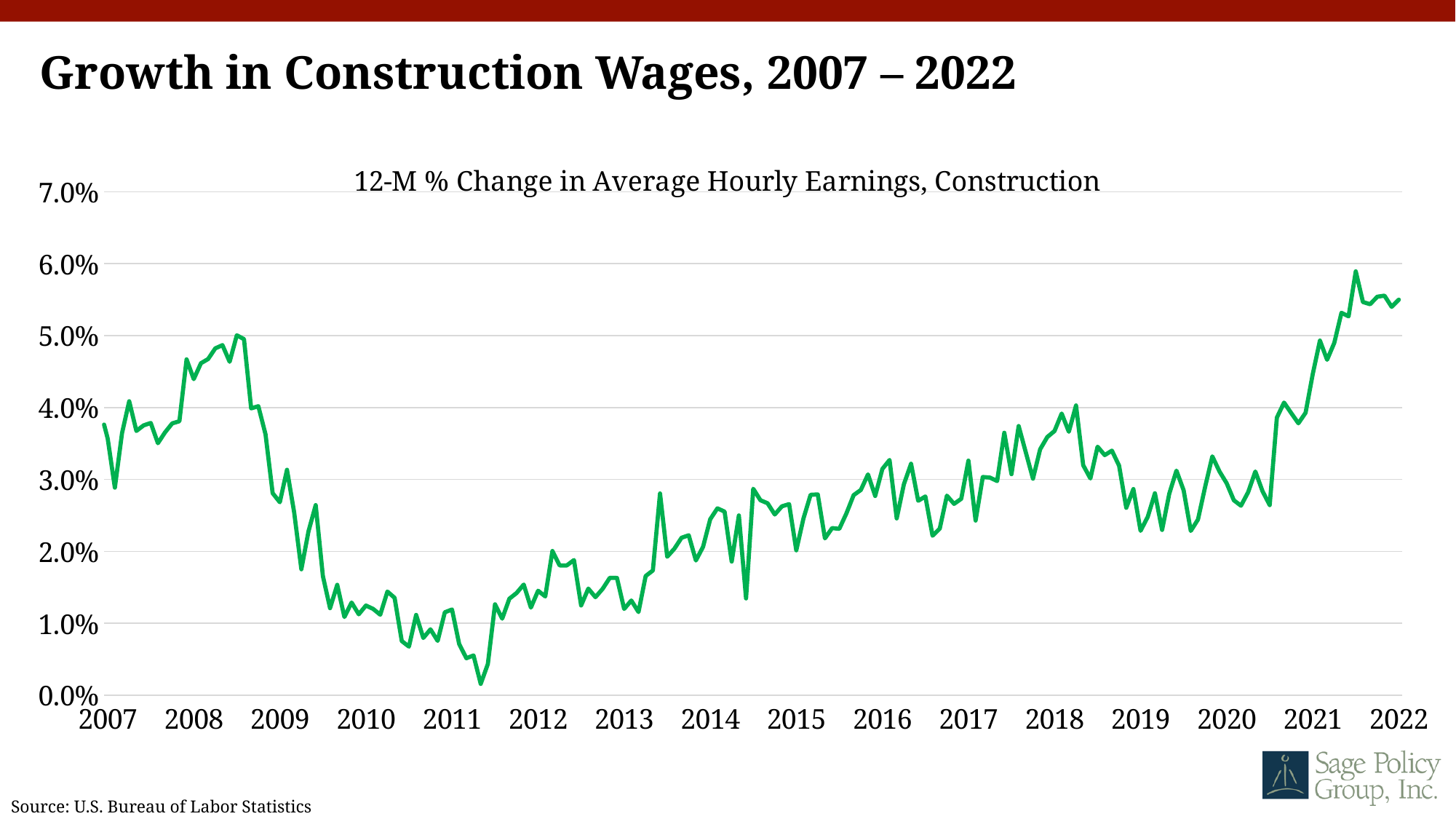
In which year does the line reach its lowest value? 2012 What is the title of the chart? 12-M % Change in Average Hourly Earnings, Construction What kind of chart is shown on the slide? line chart What is the source cited for the chart data? U.S. Bureau of Labor Statistics Does the line generally rise or fall between 2020 and 2021? rise Is the value at the start of 2022 greater or less than 5.0%? greater Does the line generally rise or fall between 2008 and 2011? fall Is the value at the start of 2007 greater or less than 3.0%? greater In which year does the line reach its highest value? 2022 Is the lowest value in 2011 greater or less than 1.0%? less How many data series are plotted on the chart? 1